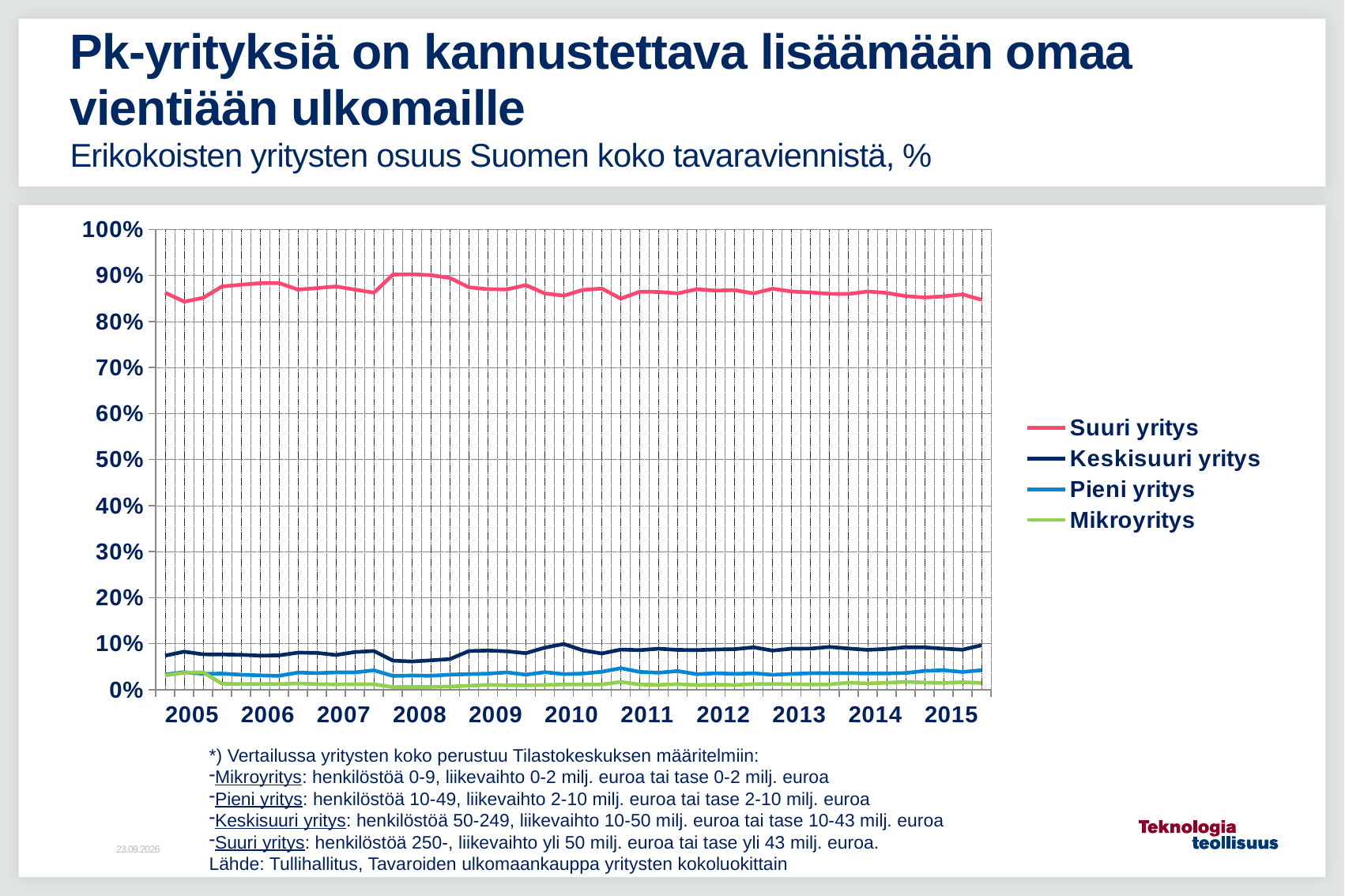
How many series does the legend list? 4 Which series has the highest values throughout the chart? Suuri yritys How many year labels are shown on the x axis? 11 Which series is drawn in green? Mikroyritys What kind of chart is shown on the slide? line chart Which is larger in 2012, the value for Keskisuuri yritys or the value for Pieni yritys? Keskisuuri yritys Is the value for Suuri yritys in 2010 greater or less than 80%? greater Is the value for Keskisuuri yritys in 2013 greater or less than 20%? less Is the value for Pieni yritys in 2008 greater or less than 10%? less What is the subtitle describing the chart's content? Erikokoisten yritysten osuus Suomen koko tavaraviennistä, %